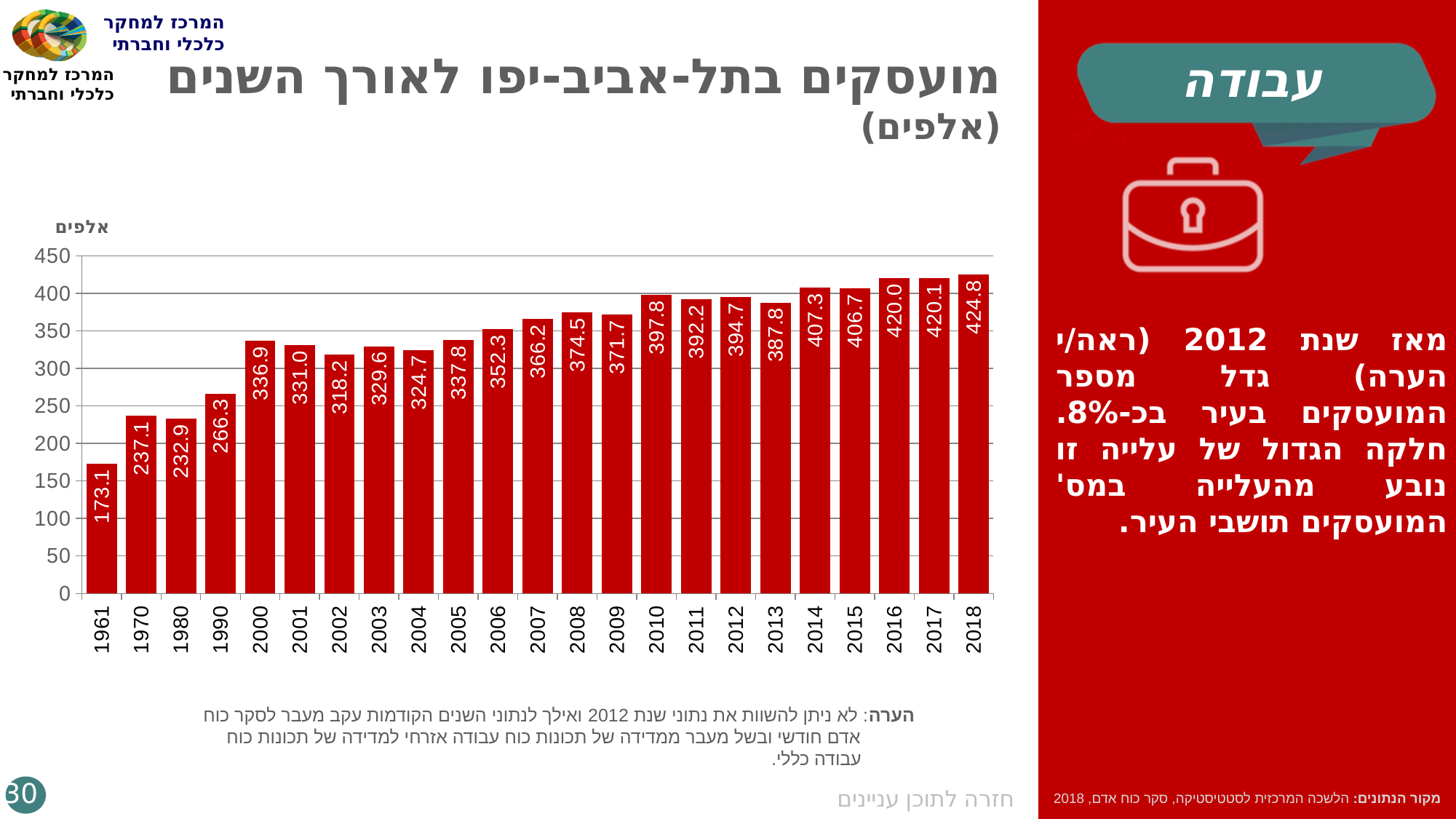
What is the difference between the values for 2000 and 1990? 70.6 Do the values generally rise or fall from 1961 to 2018? rise Which year has the highest value? 2018 What is the difference between the values for 2018 and 2012? 30.1 What is the value for 1961? 173.1 What kind of chart is this? bar chart Is the value for 2014 greater or less than 400? greater What is the value for 2018? 424.8 Which is larger, the value for 2010 or the value for 2011? 2010 How many years are shown on the x axis? 23 What is the value for 2012? 394.7 Which year has the lowest value? 1961